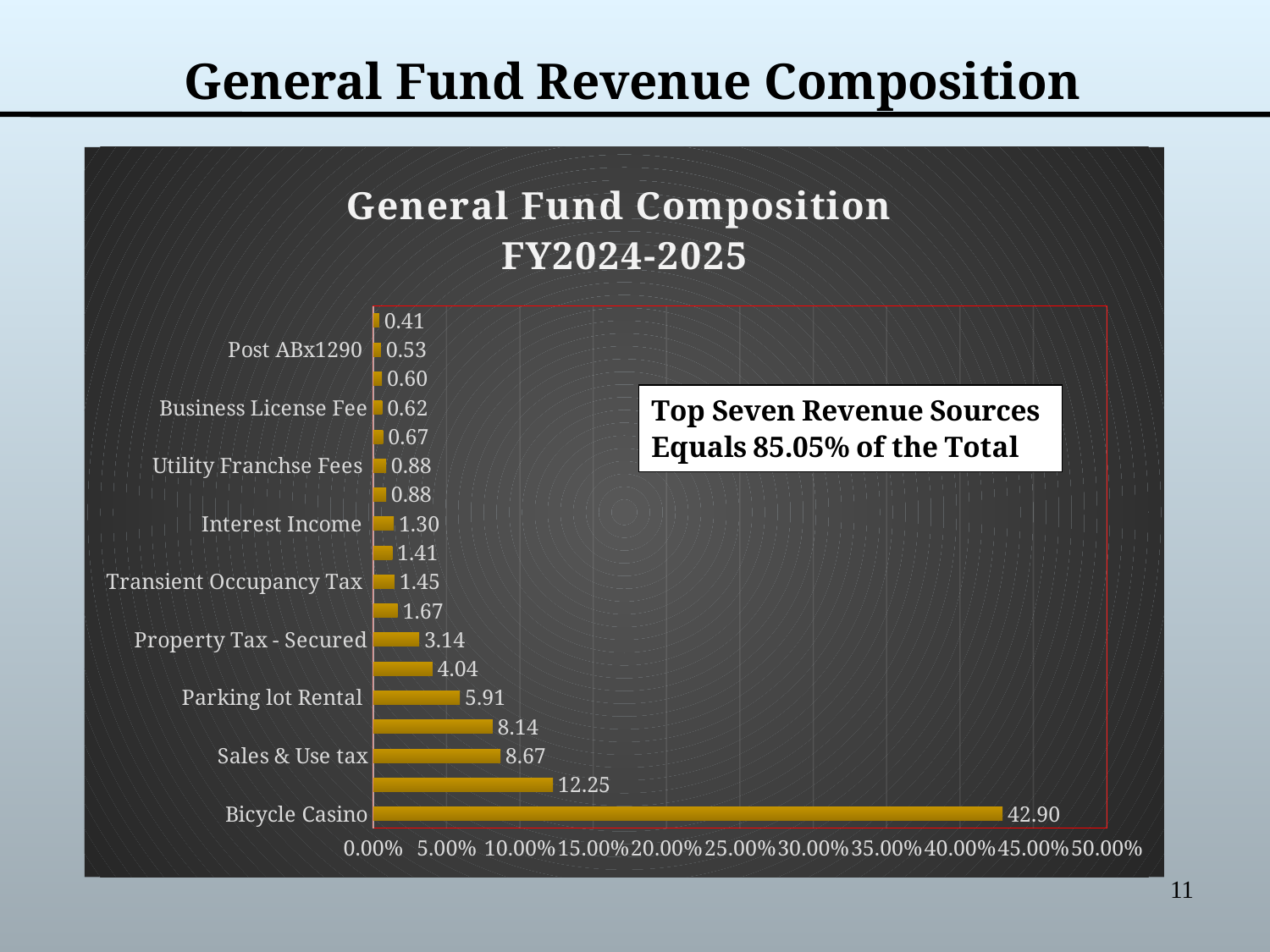
Which is larger, the value for Interest Income or the value for Transient Occupancy Tax? Transient Occupancy Tax What is the difference between the values for Sales & Use tax and Parking lot Rental? 2.76 Which labeled category has the highest value? Bicycle Casino According to the text box on the chart, what share of the total do the top seven revenue sources equal? 85.05% What is the value for Parking lot Rental? 5.91 What kind of chart is shown on the slide? bar chart What is the value for Sales & Use tax? 8.67 How many bars are plotted in the chart? 18 What is the value for Bicycle Casino? 42.90 What is the value for Post ABx1290? 0.53 What is the value for Property Tax - Secured? 3.14 Is the value for Bicycle Casino greater or less than 40.00%? greater